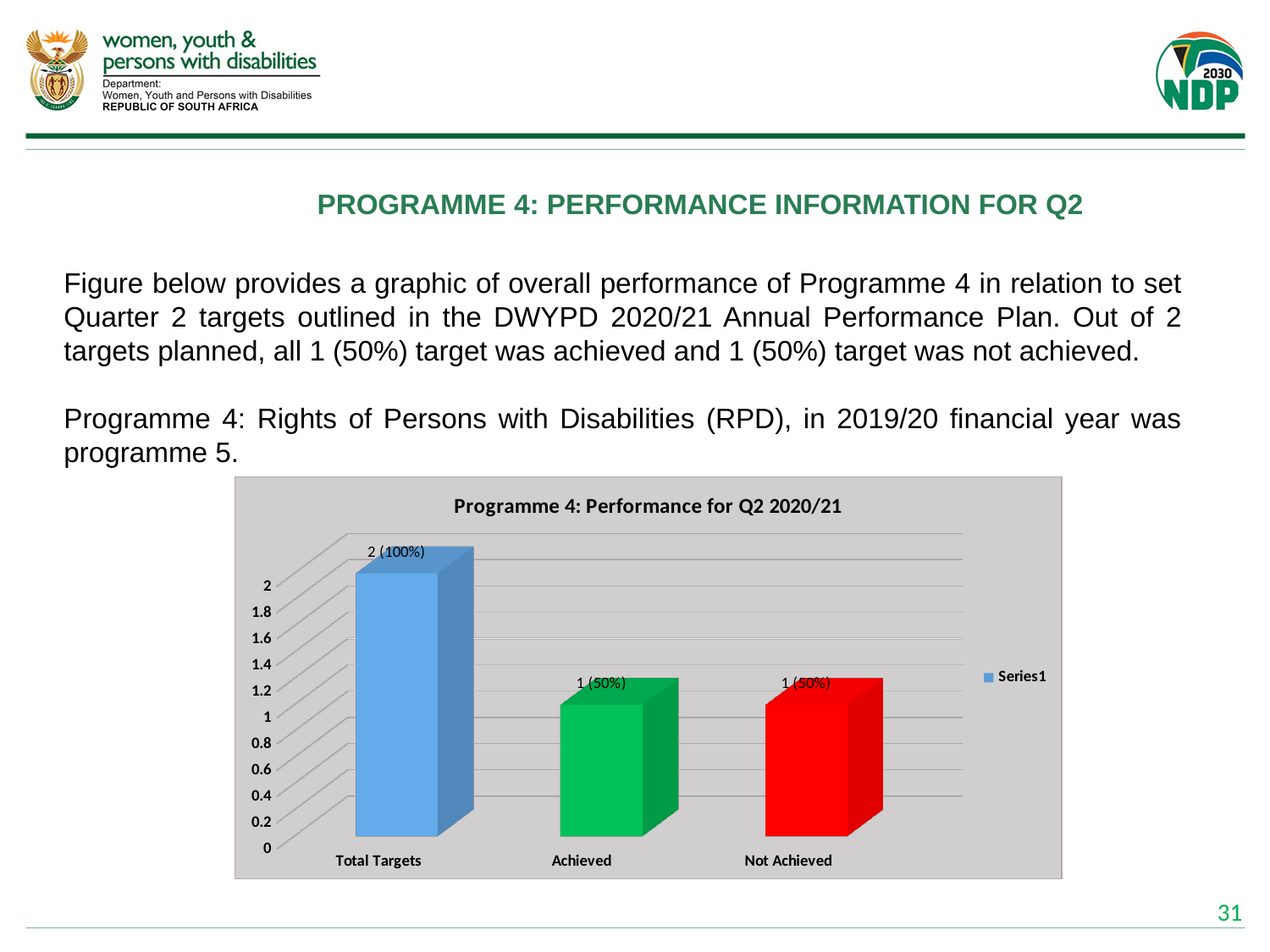
Which category has the highest bar? Total Targets What colour is the Not Achieved bar? Red What is the data label shown on the Not Achieved bar? 1 (50%) What kind of chart is shown on the slide? Bar chart Is the value for Achieved greater or less than 1.5? less How many series does the legend list? 1 What is the data label shown on the Achieved bar? 1 (50%) Which is larger, the value for Total Targets or the value for Not Achieved? Total Targets How many categories are shown on the x axis? 3 What is the difference between the Total Targets value and the Achieved value? 1 What is the data label shown on the Total Targets bar? 2 (100%) What is the title of the chart? Programme 4: Performance for Q2 2020/21